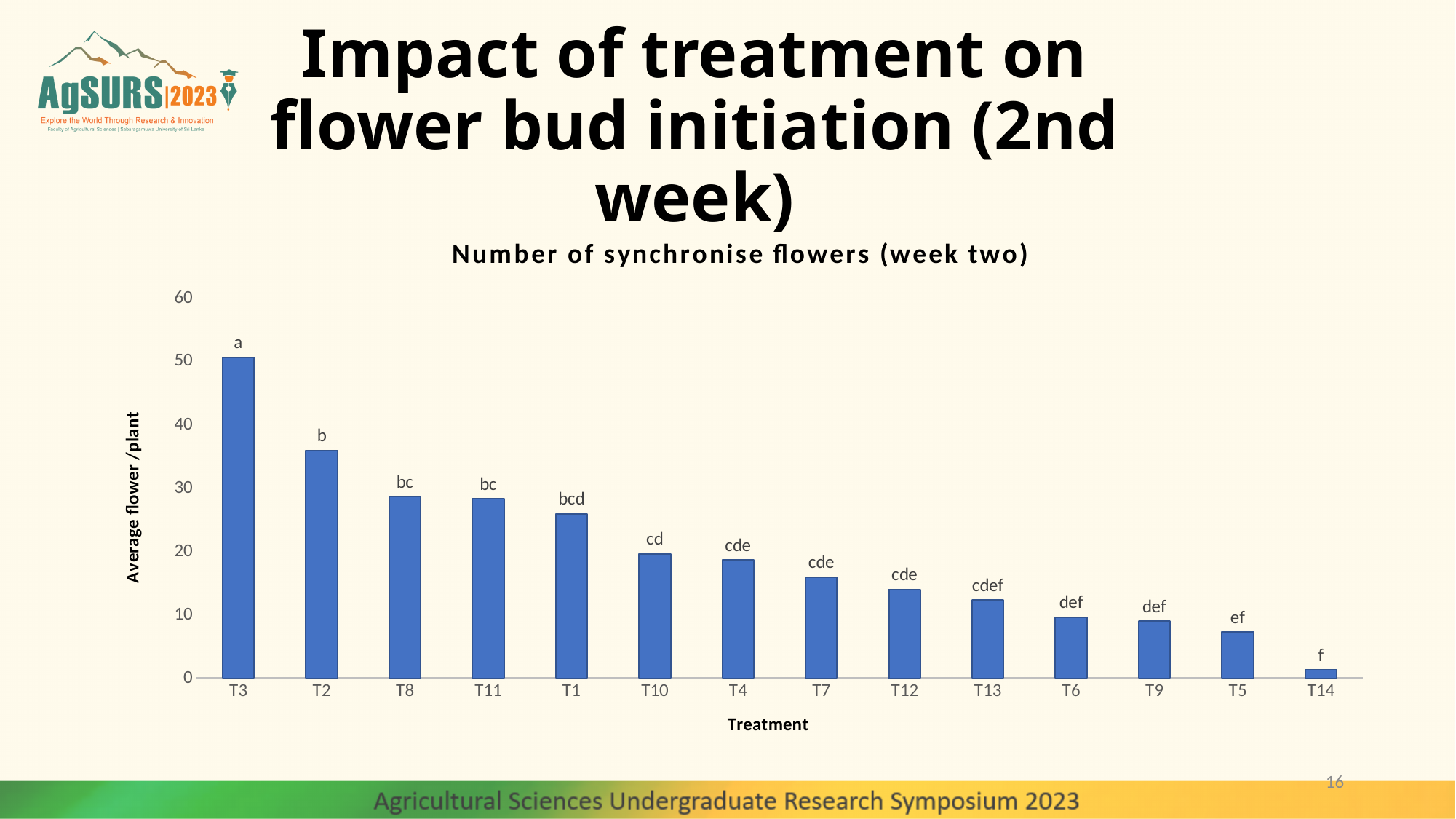
How many treatments are plotted on the x axis? 14 What is the title of the chart? Number of synchronise flowers (week two) Which treatment has the highest average flower per plant? T3 What kind of chart is shown on the slide? bar chart Which treatment has the lowest average flower per plant? T14 Is the value for T2 greater or less than 30? greater Do the bar values rise or fall from left to right along the x axis? fall Which has a larger value, T2 or T8? T2 Is the value for T8 greater or less than 30? less What letter label appears above the bar for T3? a Is the value for T5 greater or less than 10? less